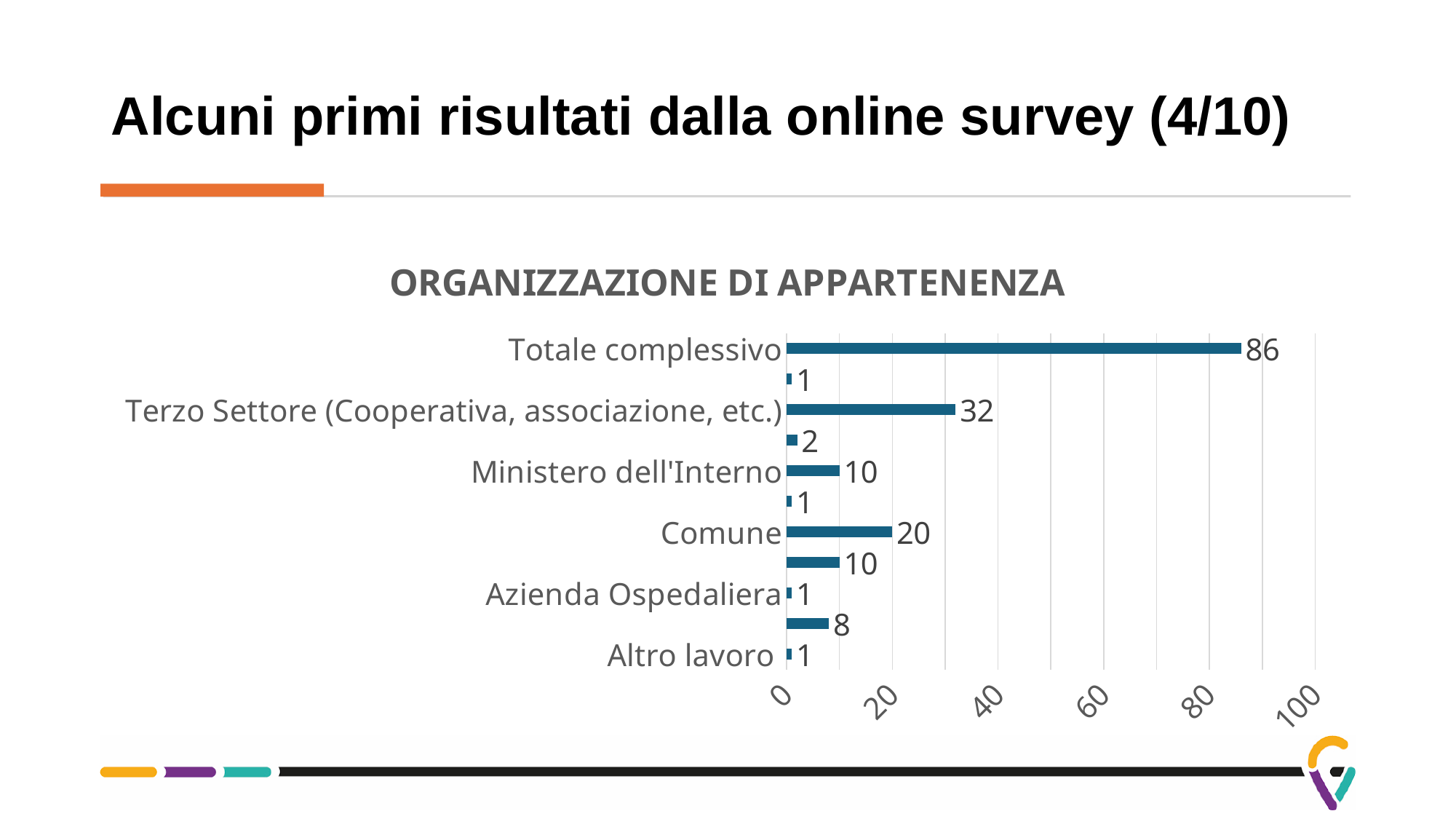
What is the value for Terzo Settore (Cooperativa, associazione, etc.)? 32 What is the difference between the values for Terzo Settore (Cooperativa, associazione, etc.) and Comune? 12 What is the value for Azienda Ospedaliera? 1 Which is larger, the value for Comune or the value for Ministero dell'Interno? Comune What is the value for Comune? 20 Which labelled category has the highest value? Totale complessivo What kind of chart is shown on the slide? bar chart What is the value for Totale complessivo? 86 What is the value for Altro lavoro? 1 What is the title of the chart? ORGANIZZAZIONE DI APPARTENENZA Is the value for Terzo Settore (Cooperativa, associazione, etc.) greater or less than 40? less What is the value for Ministero dell'Interno? 10